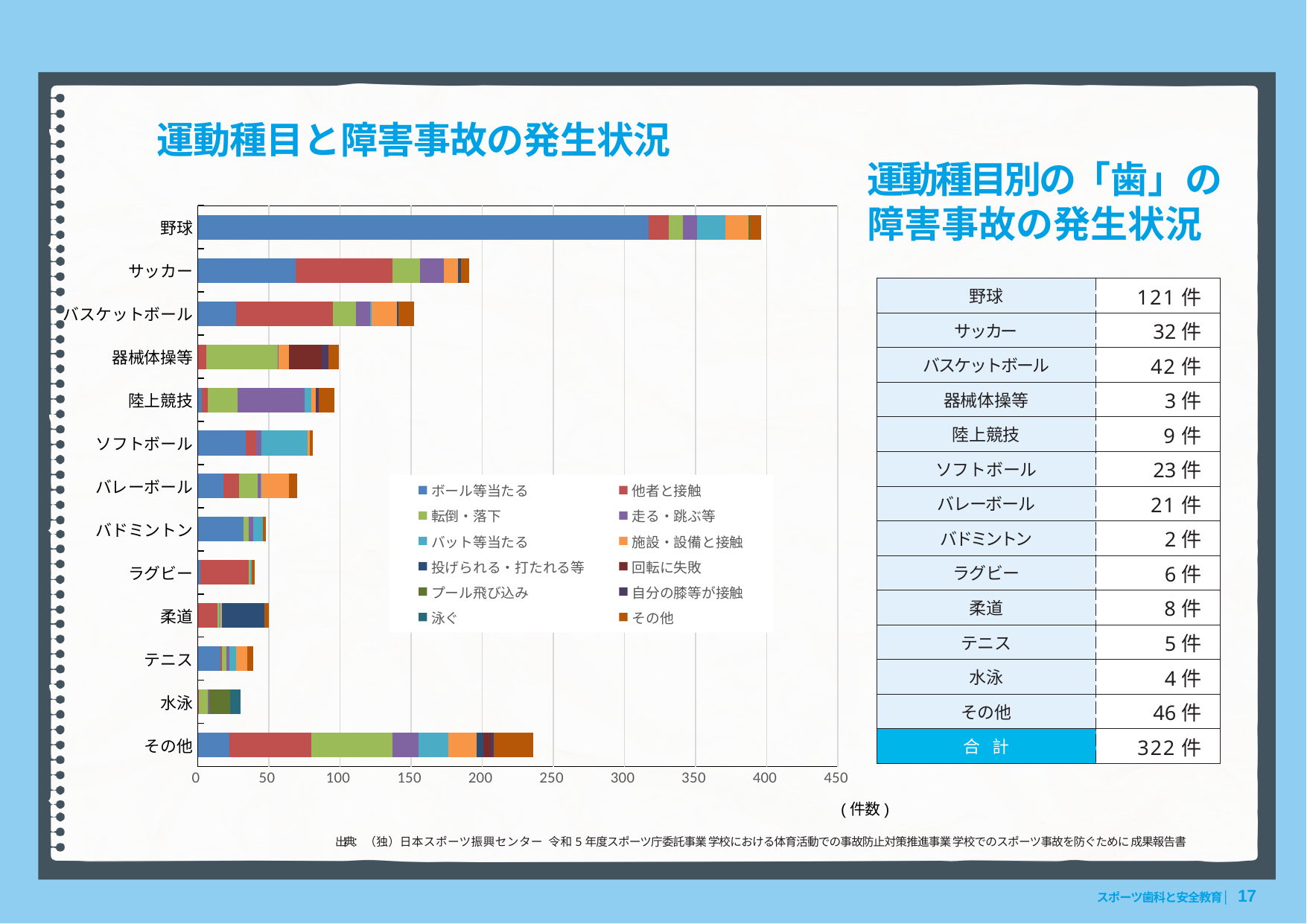
What kind of chart is shown on the slide? Stacked bar chart Is the total bar length for サッカー greater or less than 150? greater Which sport category has the shortest bar in the chart? 水泳 Which bar is longer in the chart, 野球 or サッカー? 野球 Which bar is longer in the chart, その他 or バスケットボール? その他 Is the total bar length for 野球 greater or less than 350? greater Is the total bar length for ソフトボール greater or less than 100? less What is the title of the chart on the slide? 運動種目と障害事故の発生状況 Which sport category has the longest bar in the chart? 野球 How many series does the chart's legend list? 12 How many sport categories are plotted on the y axis of the chart? 13